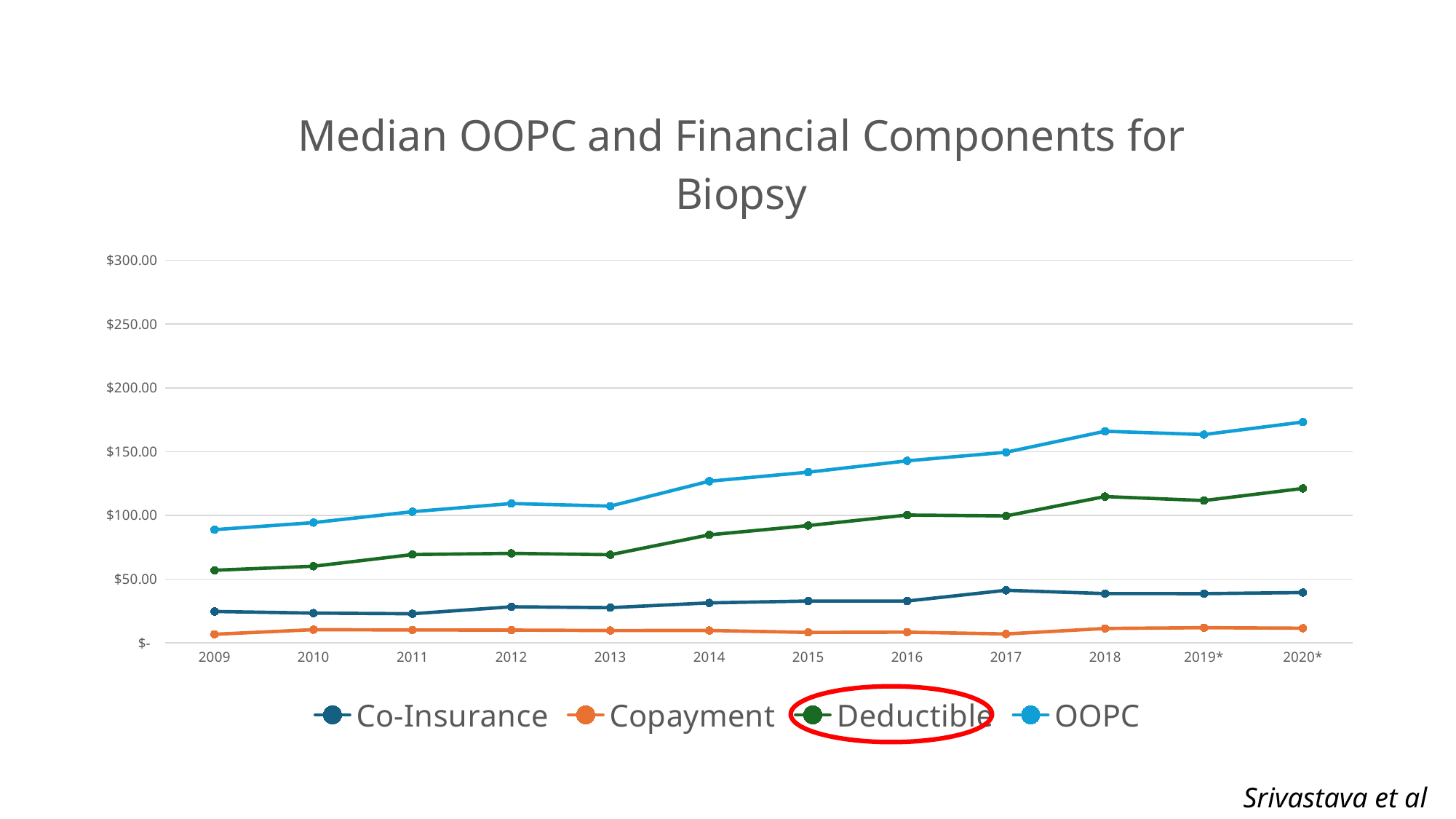
Is the OOPC value for 2020* greater or less than $150.00? greater Which series has the highest value in 2020*? OOPC In 2014, which is larger: the OOPC value or the Deductible value? OOPC Which series has the lowest values across the years shown? Copayment What kind of chart is shown on the slide? Line chart Is the OOPC value for 2009 greater or less than $100.00? less Does the OOPC line generally rise or fall from 2009 to 2020*? Rise How many years are plotted along the x axis? 12 Which legend entry is circled in red? Deductible Is the Copayment value for 2020* greater or less than $50.00? less How many series does the legend list? 4